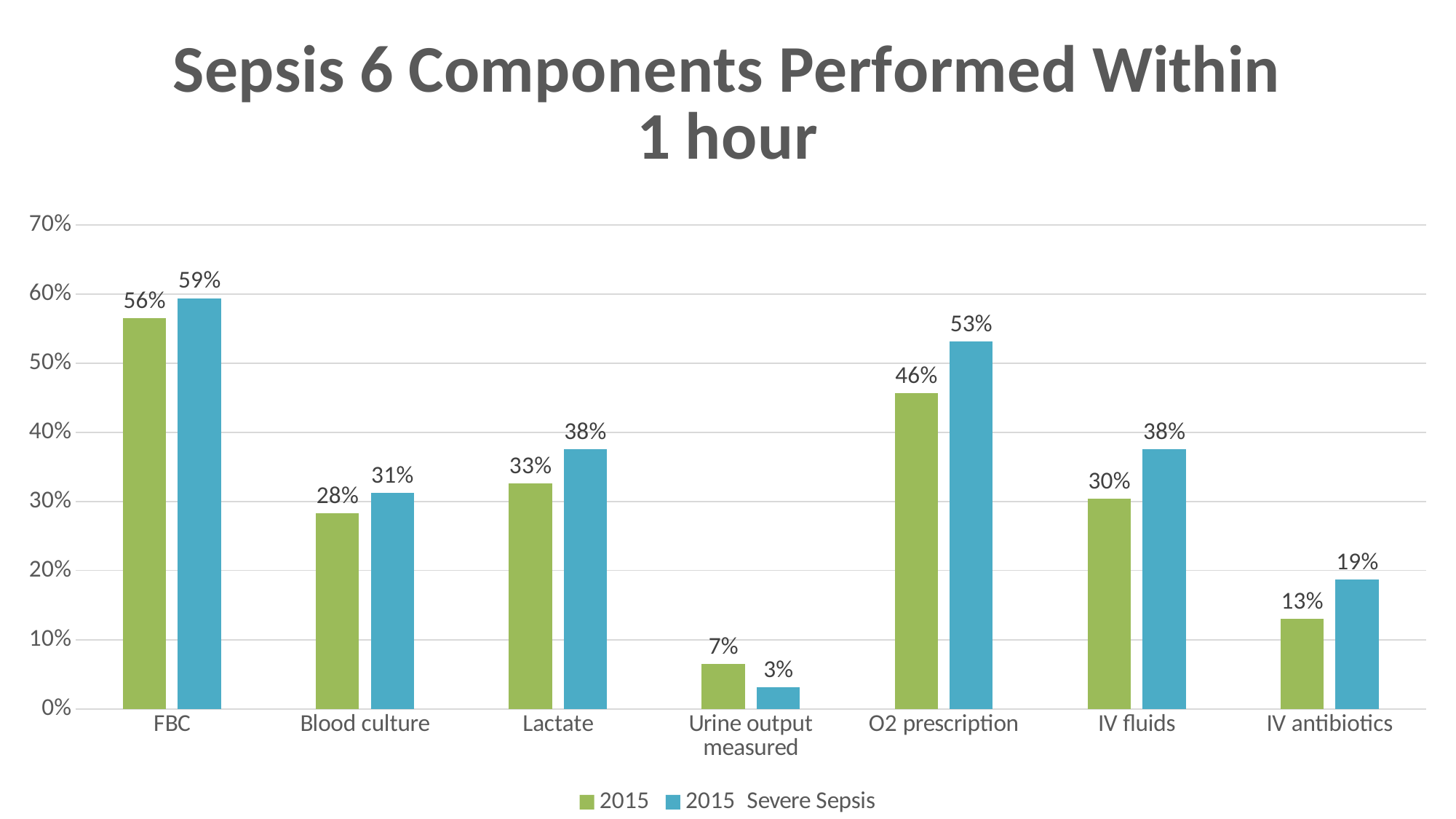
Which category has the lowest 2015 value? Urine output measured What is the title of the chart? Sepsis 6 Components Performed Within 1 hour What is the 2015 value for FBC? 56% How many series does the legend list? 2 What is the 2015 value for Urine output measured? 7% What is the difference between the 2015 Severe Sepsis and 2015 values for IV fluids? 8% What kind of chart is shown on the slide? Bar chart What is the 2015 Severe Sepsis value for O2 prescription? 53% Which is larger for Urine output measured: the 2015 value or the 2015 Severe Sepsis value? 2015 Which category has the highest 2015 Severe Sepsis value? FBC How many categories are shown on the x axis? 7 Is the 2015 Severe Sepsis value for Lactate greater or less than 30%? greater